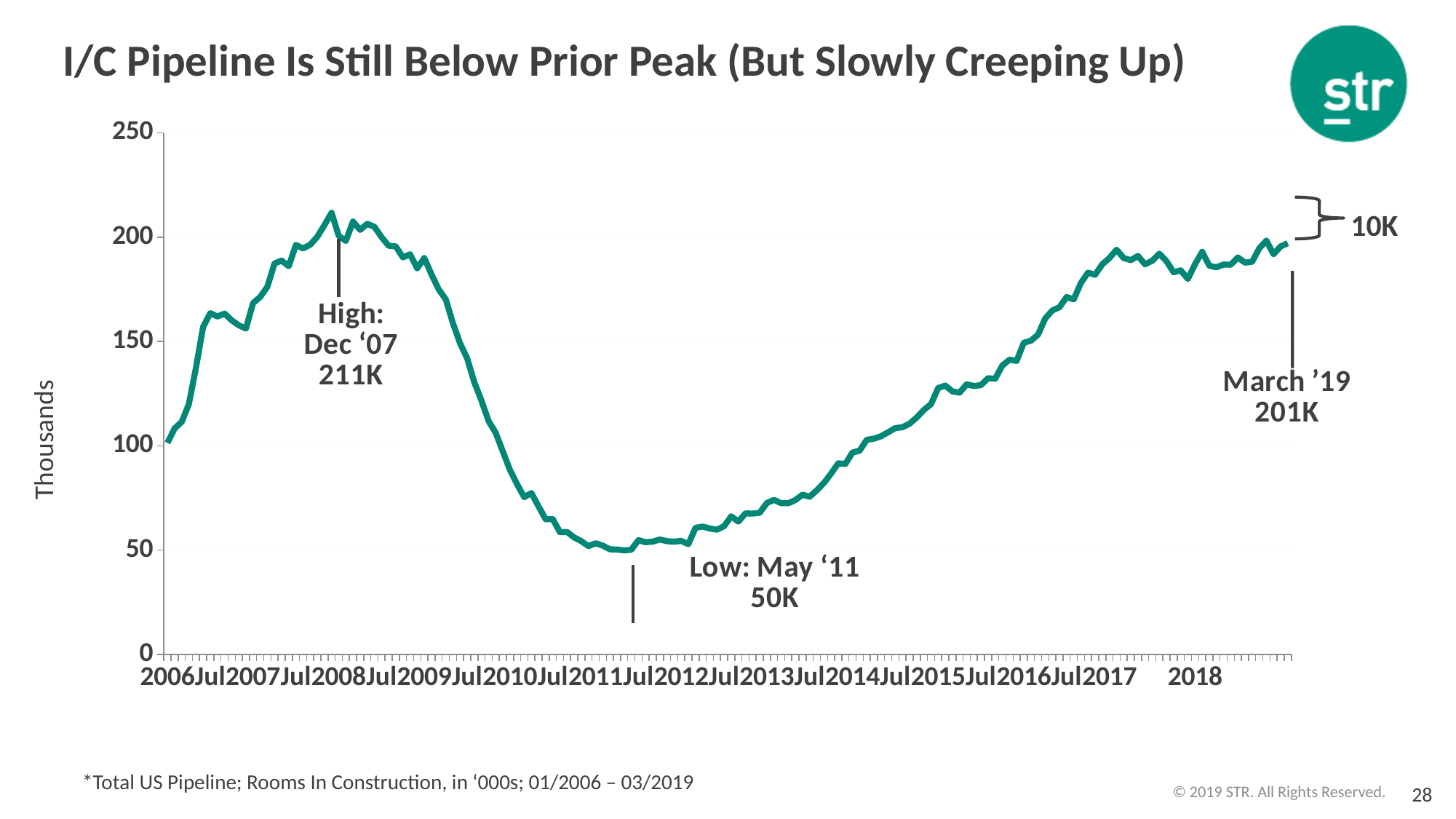
According to the annotation, how far below the prior peak is the March '19 value? 10K What was the value of the I/C pipeline at its high in Dec '07? 211K Does the I/C pipeline rise or fall between Jul 2011 and Jul 2017? rise What was the value of the I/C pipeline in March '19? 201K Is the value at Jul 2010 greater or less than 100? less What was the value of the I/C pipeline at its low in May '11? 50K Which is larger, the Dec '07 high or the March '19 value? Dec '07 high In which month did the I/C pipeline reach its highest point? Dec '07 What is the label on the vertical axis? Thousands In which month did the I/C pipeline reach its lowest point? May '11 What is the difference between the Dec '07 high and the May '11 low? 161K What type of chart is shown on the slide? line chart